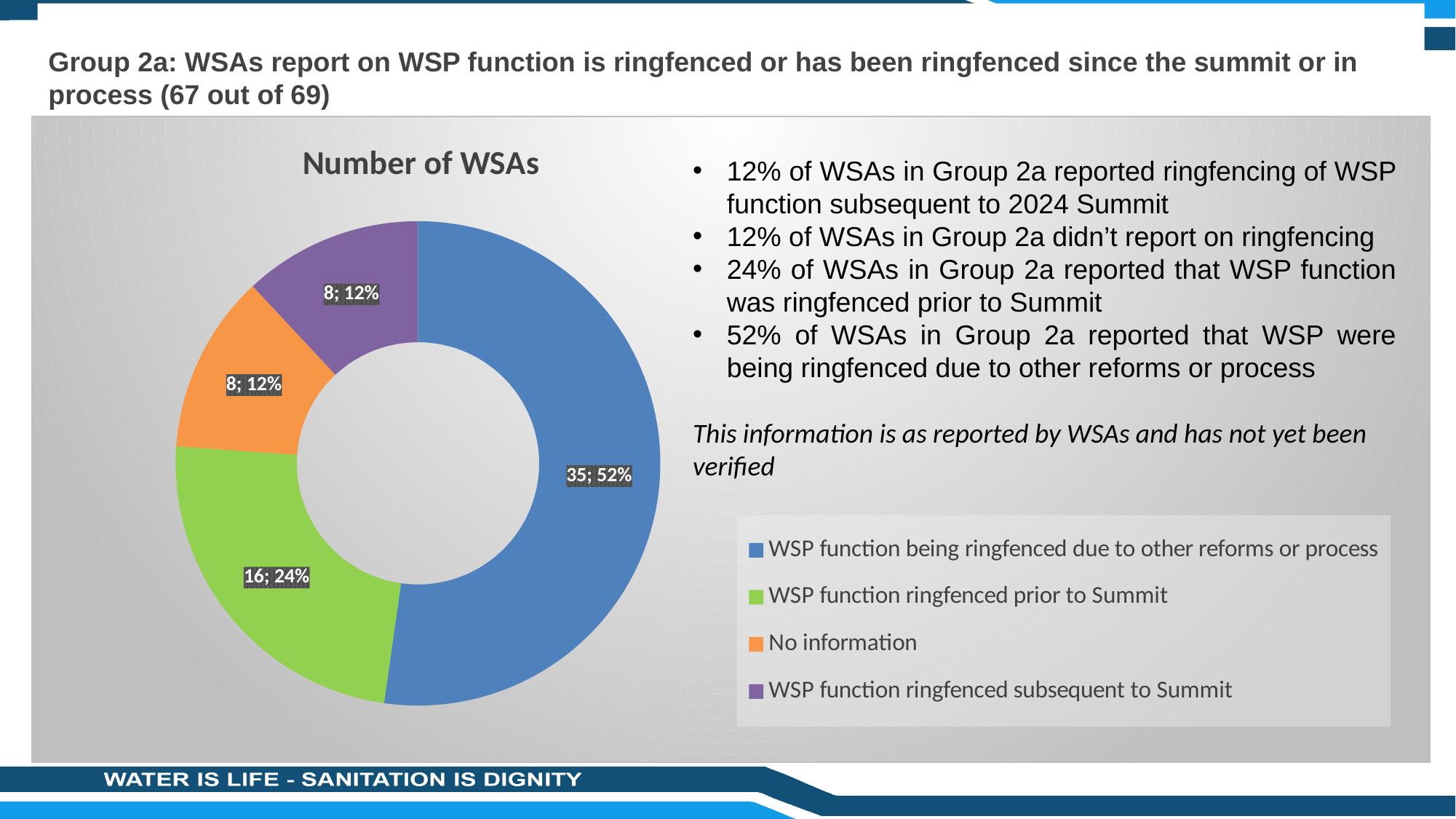
How many WSAs fall under 'No information'? 8 What share of the pie is 'WSP function ringfenced prior to Summit'? 24% How many WSAs reported the WSP function ringfenced prior to Summit? 16 How many categories does the legend list? 4 What share of the pie is 'WSP function ringfenced subsequent to Summit'? 12% Which is larger: 'WSP function ringfenced prior to Summit' or 'No information'? WSP function ringfenced prior to Summit How many WSAs reported the WSP function being ringfenced due to other reforms or process? 35 What colour is the 'No information' slice? Orange Which category has the largest slice? WSP function being ringfenced due to other reforms or process What is the title of the chart? Number of WSAs What is the difference in number of WSAs between 'WSP function being ringfenced due to other reforms or process' and 'WSP function ringfenced prior to Summit'? 19 What kind of chart is shown on the slide? Pie chart (doughnut)